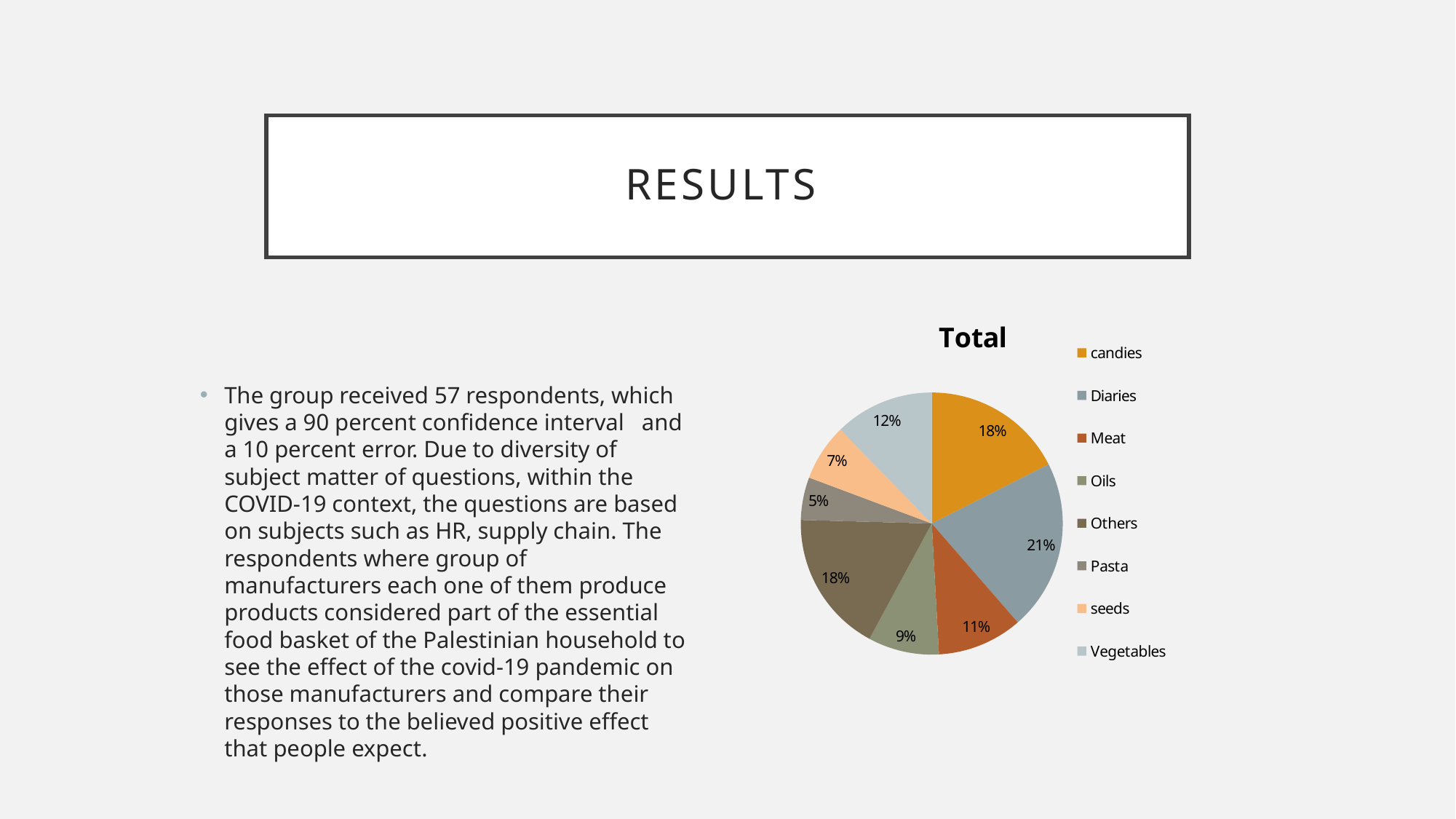
What share of the pie does Diaries have? 21% What share of the pie does Meat have? 11% What type of chart is shown on the slide? pie chart What share of the pie does Pasta have? 5% Which category has the largest share of the pie? Diaries How many categories does the pie chart show? 8 What share of the pie does Vegetables have? 12% What is the difference between the shares for Diaries and Oils? 12% Which has a larger share, seeds or Vegetables? Vegetables Which category has the smallest share of the pie? Pasta What is the title of the chart? Total What is the combined share of candies and Others? 36%